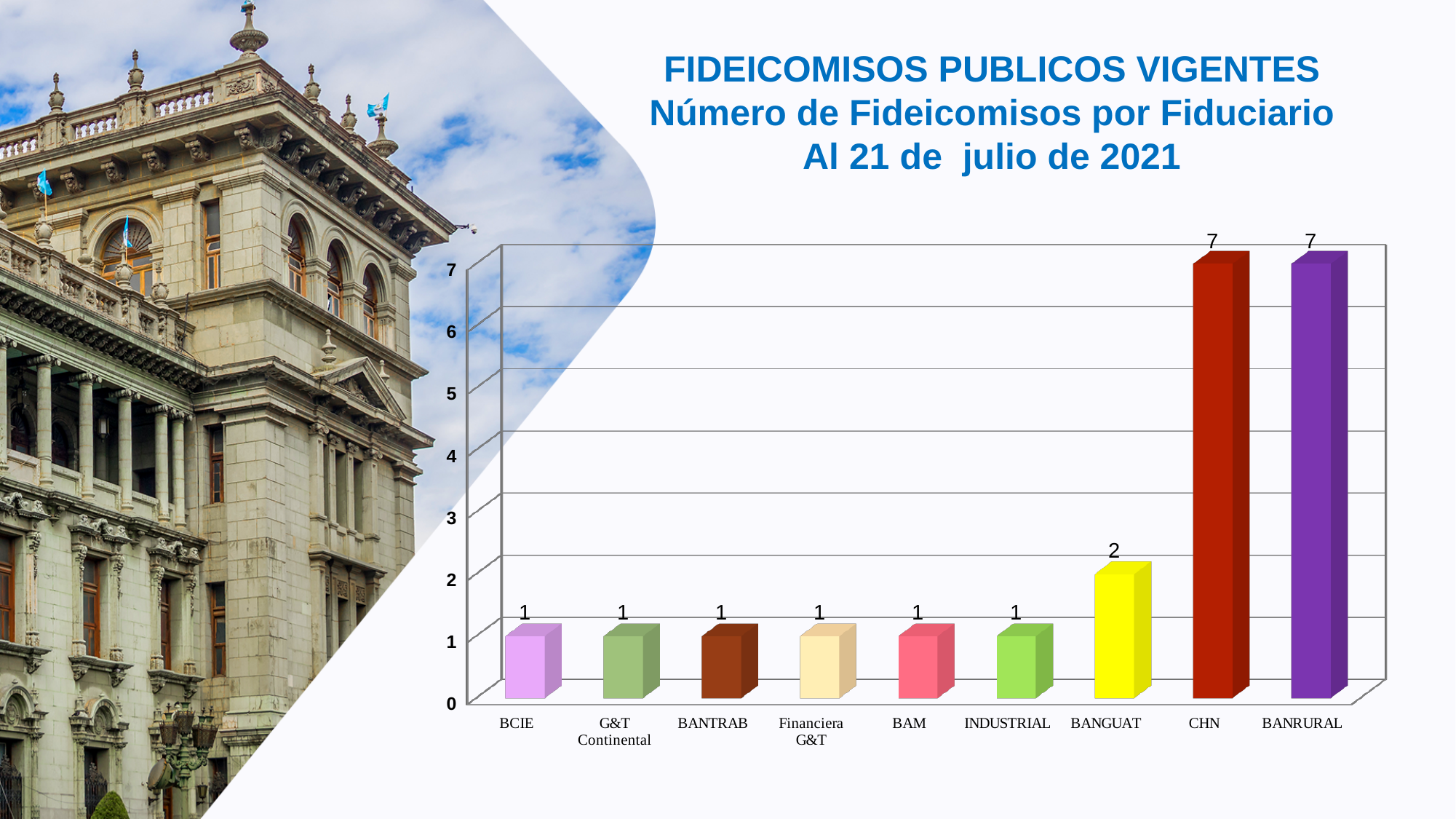
What colour is the bar for CHN? red What is the difference between the values for CHN and BANGUAT? 5 Which is larger, the value for BANGUAT or the value for BANTRAB? BANGUAT Which categories have the highest value? CHN and BANRURAL What is the value for INDUSTRIAL? 1 What is the value for BCIE? 1 What kind of chart is shown on the slide? bar chart How many categories are shown on the x axis? 9 Is the value for BANRURAL greater or less than 5? greater What is the value for BANGUAT? 2 What is the value for CHN? 7 What is the difference between the values for BANGUAT and BAM? 1